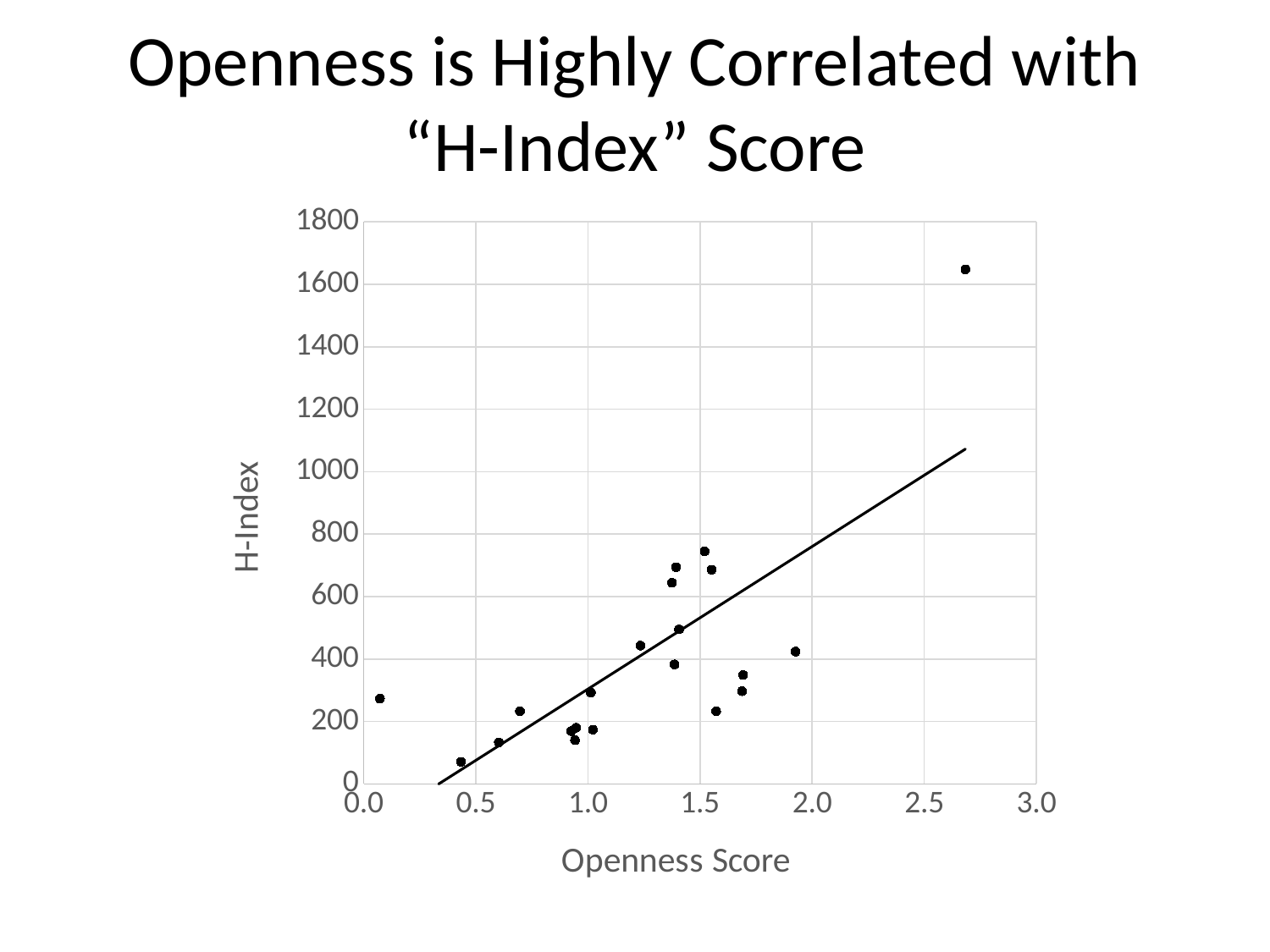
What kind of chart is shown on the slide? scatter plot Is the Openness Score of the leftmost point greater or less than 0.5? less What is the maximum value shown on the H-Index axis? 1800 What is the title of the chart? Openness is Highly Correlated with "H-Index" Score Is the H-Index of the lowest point greater or less than 200? less Is the H-Index of the highest point greater or less than 1400? greater Does the trend line slope upward or downward? upward Do H-Index values generally rise or fall as Openness Score increases? rise What is the label of the x axis? Openness Score